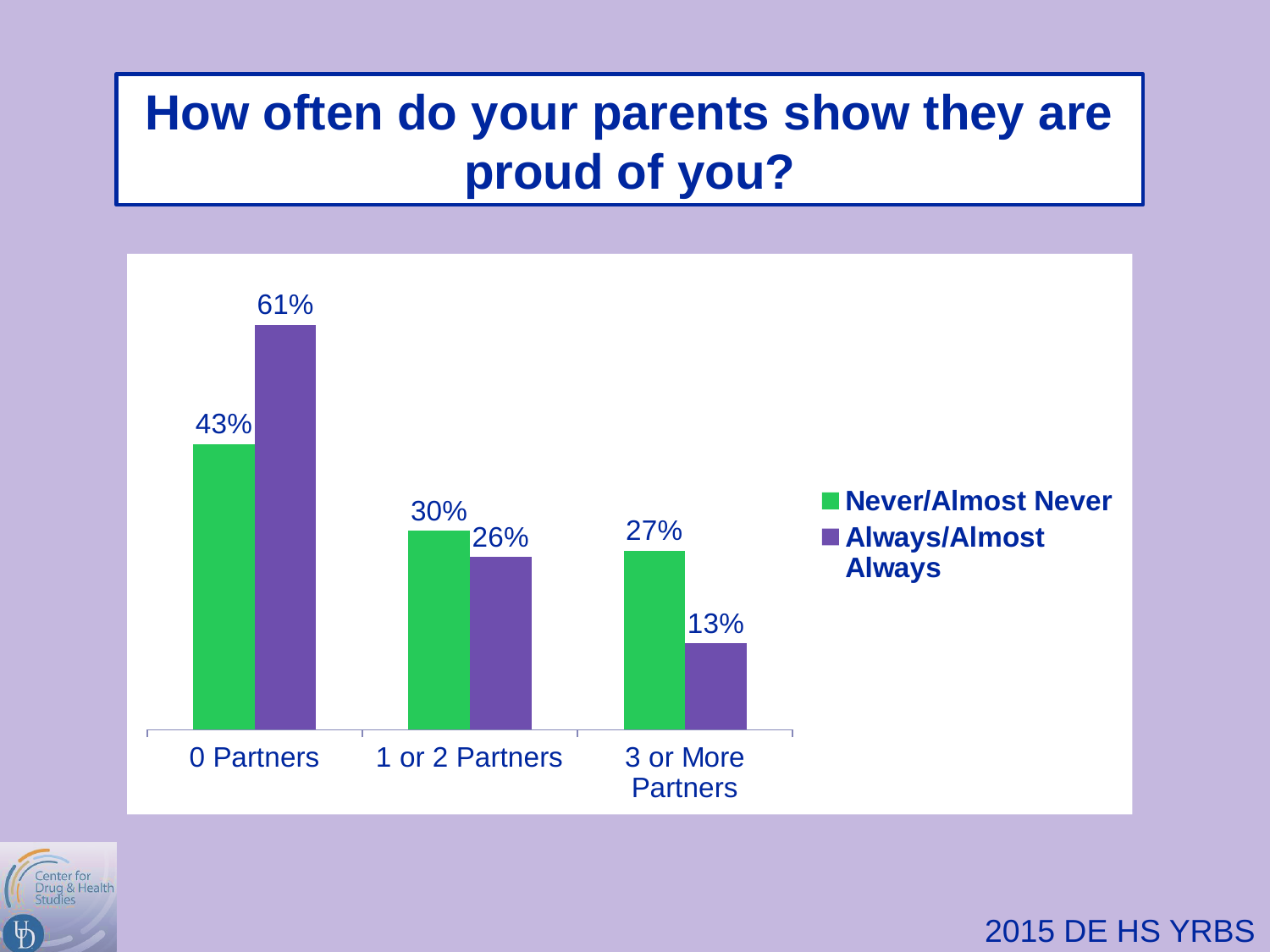
How many categories are shown on the x axis? 3 In the 1 or 2 Partners category, which series has the larger value? Never/Almost Never What kind of chart is shown on the slide? Bar chart Which category has the lowest Never/Almost Never value? 3 or More Partners What is the value for Always/Almost Always in the 1 or 2 Partners category? 26% Do the Always/Almost Always values rise or fall from 0 Partners to 3 or More Partners? Fall What is the difference between the Never/Almost Never and Always/Almost Always values for 3 or More Partners? 14% How many series does the legend list? 2 Which category has the highest Always/Almost Always value? 0 Partners What is the difference between the Always/Almost Always and Never/Almost Never values for 0 Partners? 18% What is the value for Always/Almost Always in the 0 Partners category? 61% What is the value for Never/Almost Never in the 3 or More Partners category? 27%